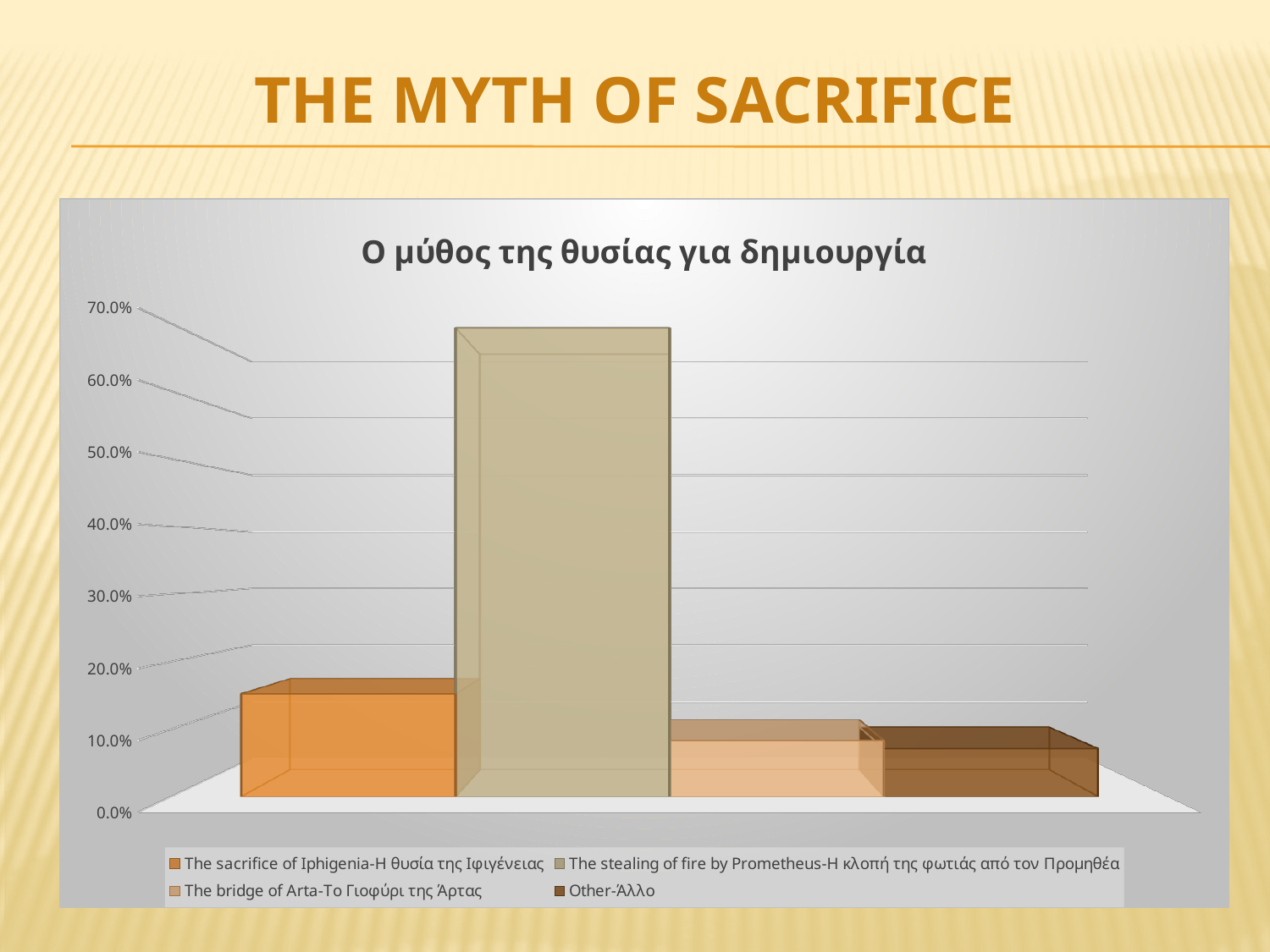
How many series does the legend list? 4 What is the title of the chart? Ο μύθος της θυσίας για δημιουργία Is the value for The sacrifice of Iphigenia greater or less than 20.0%? less What kind of chart is shown on the slide? bar chart Which is larger, the value for The sacrifice of Iphigenia or the value for The bridge of Arta? The sacrifice of Iphigenia Is the value for The stealing of fire by Prometheus greater or less than 60.0%? greater Which series has the highest value? The stealing of fire by Prometheus-Η κλοπή της φωτιάς από τον Προμηθέα Is the value for The sacrifice of Iphigenia greater or less than 10.0%? greater How many bars are plotted in the chart? 4 Which is larger, the value for The stealing of fire by Prometheus or the value for The sacrifice of Iphigenia? The stealing of fire by Prometheus